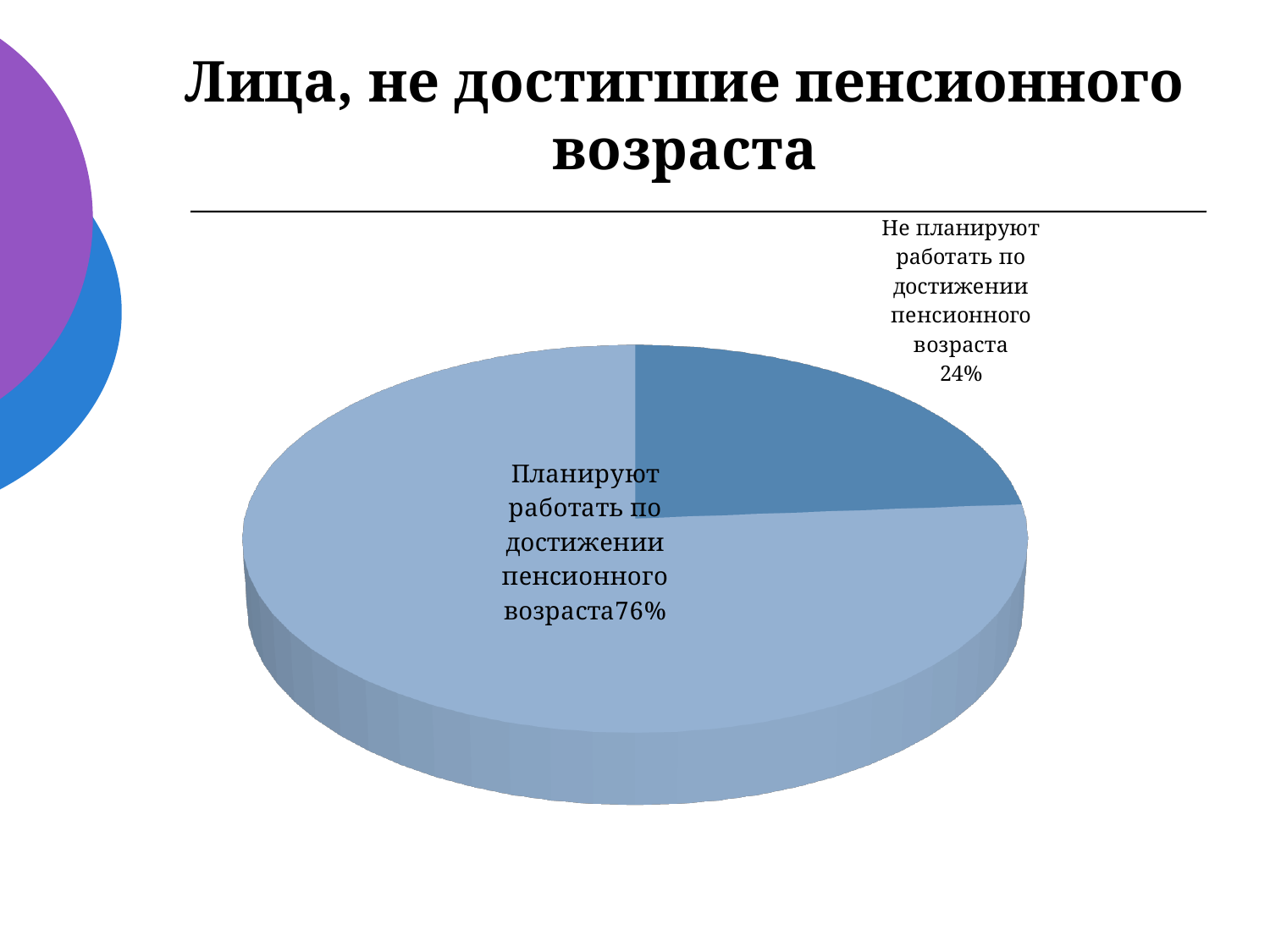
How many slices does the pie chart have? 2 Which slice of the pie is the smallest? Не планируют работать по достижении пенсионного возраста What is the title of the slide containing the pie chart? Лица, не достигшие пенсионного возраста What share of the pie is labelled "Не планируют работать по достижении пенсионного возраста"? 24% Which slice of the pie is the largest? Планируют работать по достижении пенсионного возраста What kind of chart is shown on the slide? pie chart What share of the pie is labelled "Планируют работать по достижении пенсионного возраста"? 76% Is the share of those who do not plan to work after reaching retirement age greater or less than 50%? less What is the difference in percentage points between the "Планируют работать" slice and the "Не планируют работать" slice? 52 Which is larger: the share of those who plan to work after reaching retirement age or the share of those who do not? Планируют работать по достижении пенсионного возраста What is the total of the two slices shown in the pie chart? 100%